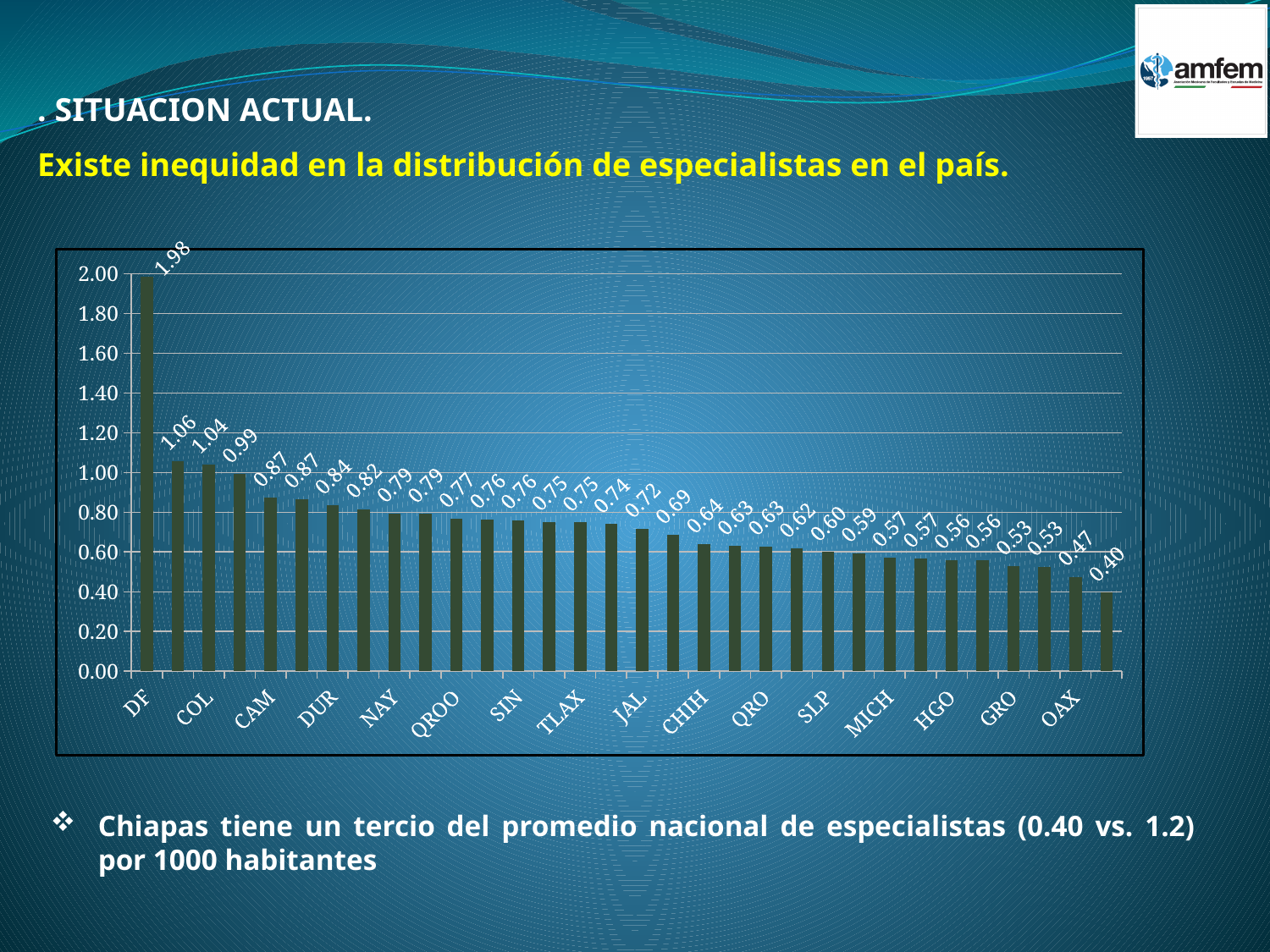
What is the difference between the values for DF and COL? 0.94 What is the highest tick value shown on the vertical axis? 2.00 What is the value for OAX? 0.47 Which is larger, the value for CAM or the value for SLP? CAM What is the value for JAL? 0.72 What is the lowest value shown on the chart? 0.40 What is the value for DF? 1.98 Do the values rise or fall from left to right along the x axis? fall Which category has the highest value? DF What is the value for COL? 1.04 What kind of chart is shown on the slide? bar chart How many bars are plotted on the chart? 32